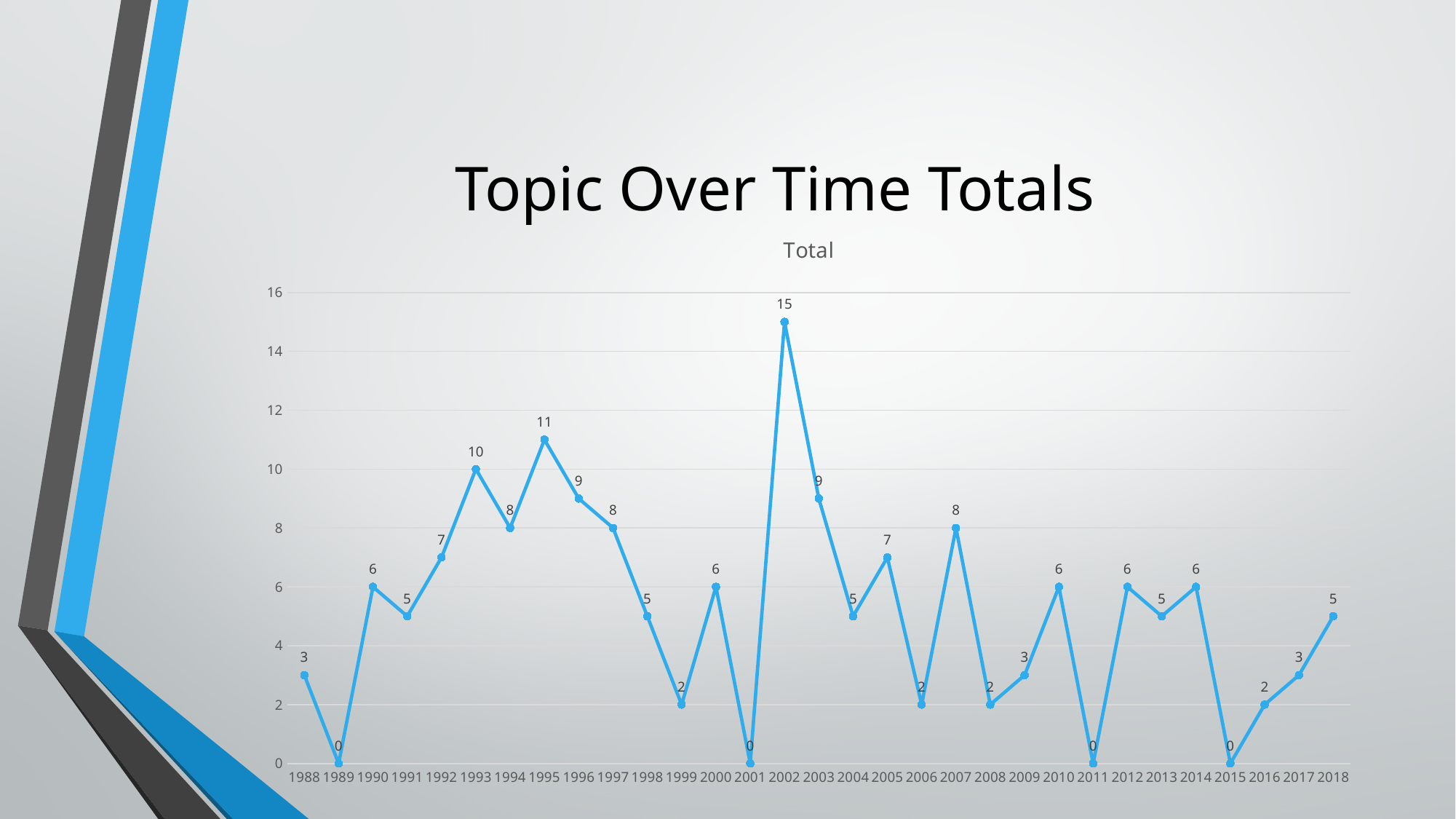
How many years are plotted on the x axis? 31 Which year has the highest value? 2002 What is the value for 1995? 11 What is the difference between the values for 1993 and 1988? 7 What is the difference between the values for 2002 and 2003? 6 Which is larger, the value for 1996 or the value for 2005? 1996 What is the title of the chart? Total What kind of chart is shown on the slide? line chart What is the value for 2002? 15 What is the value for 2007? 8 Is the value for 1995 greater or less than 10? greater What is the value for 2018? 5